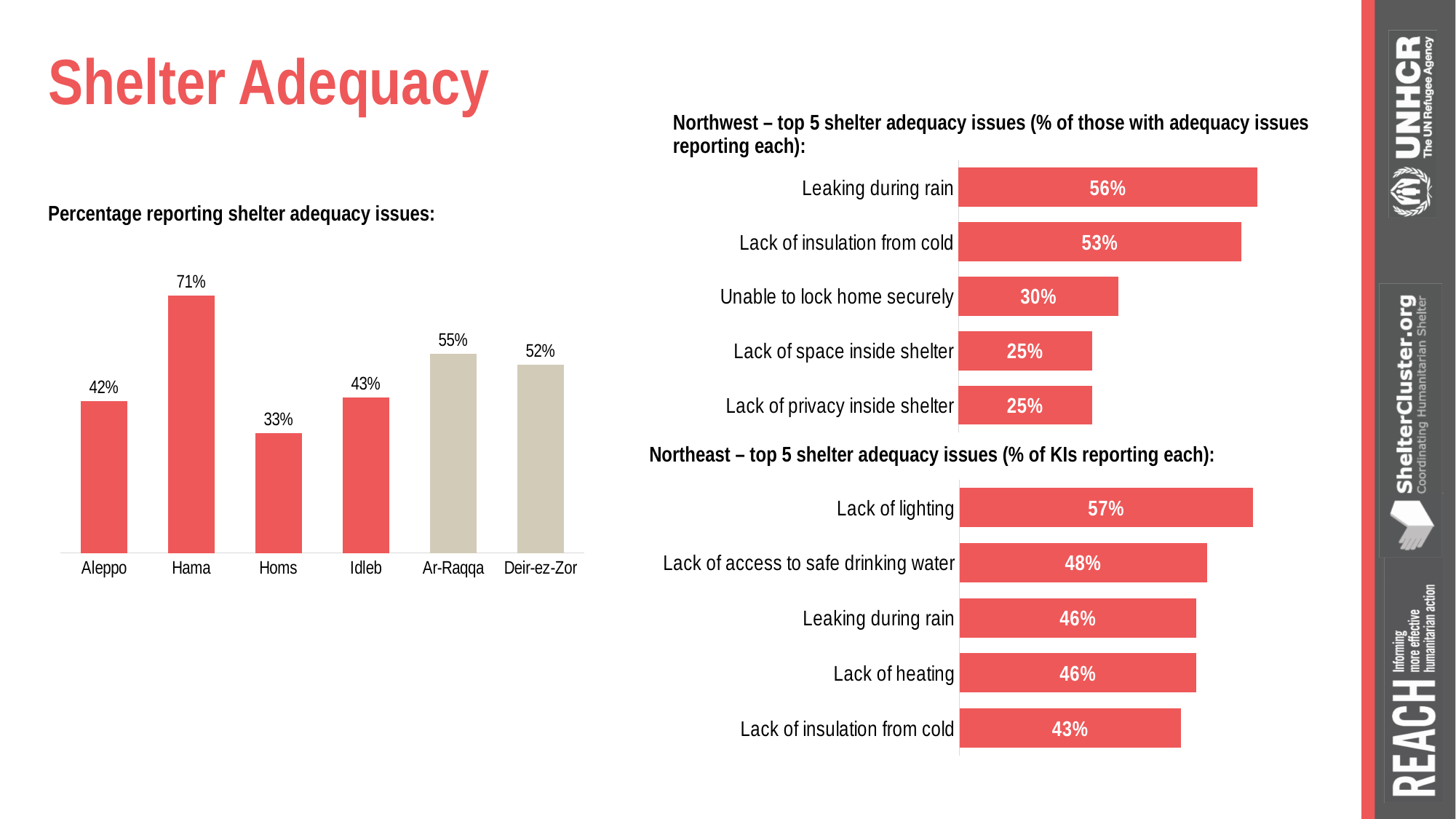
In the Northwest top 5 shelter adequacy issues chart, what is the difference between lack of insulation from cold and unable to lock home securely? 23% In the Northwest top 5 shelter adequacy issues chart, which issue has the highest percentage? Leaking during rain In the 'Percentage reporting shelter adequacy issues' chart, what is the difference between Ar-Raqqa and Aleppo? 13% In the Northeast top 5 shelter adequacy issues chart, which issue has the lowest percentage? Lack of insulation from cold In the 'Percentage reporting shelter adequacy issues' chart, which governorates have bars coloured beige rather than red? Ar-Raqqa and Deir-ez-Zor In the Northeast top 5 shelter adequacy issues chart, what percentage of KIs reported lack of access to safe drinking water? 48% In the 'Percentage reporting shelter adequacy issues' chart, what is the value for Hama? 71% In the Northwest top 5 shelter adequacy issues chart, what percentage reported leaking during rain? 56% In the 'Percentage reporting shelter adequacy issues' chart, which is larger, Idleb or Deir-ez-Zor? Deir-ez-Zor In the 'Percentage reporting shelter adequacy issues' chart, which governorate has the lowest value? Homs What kind of chart is the Northeast top 5 shelter adequacy issues chart? Bar chart In the 'Percentage reporting shelter adequacy issues' chart, how many governorates are shown? 6